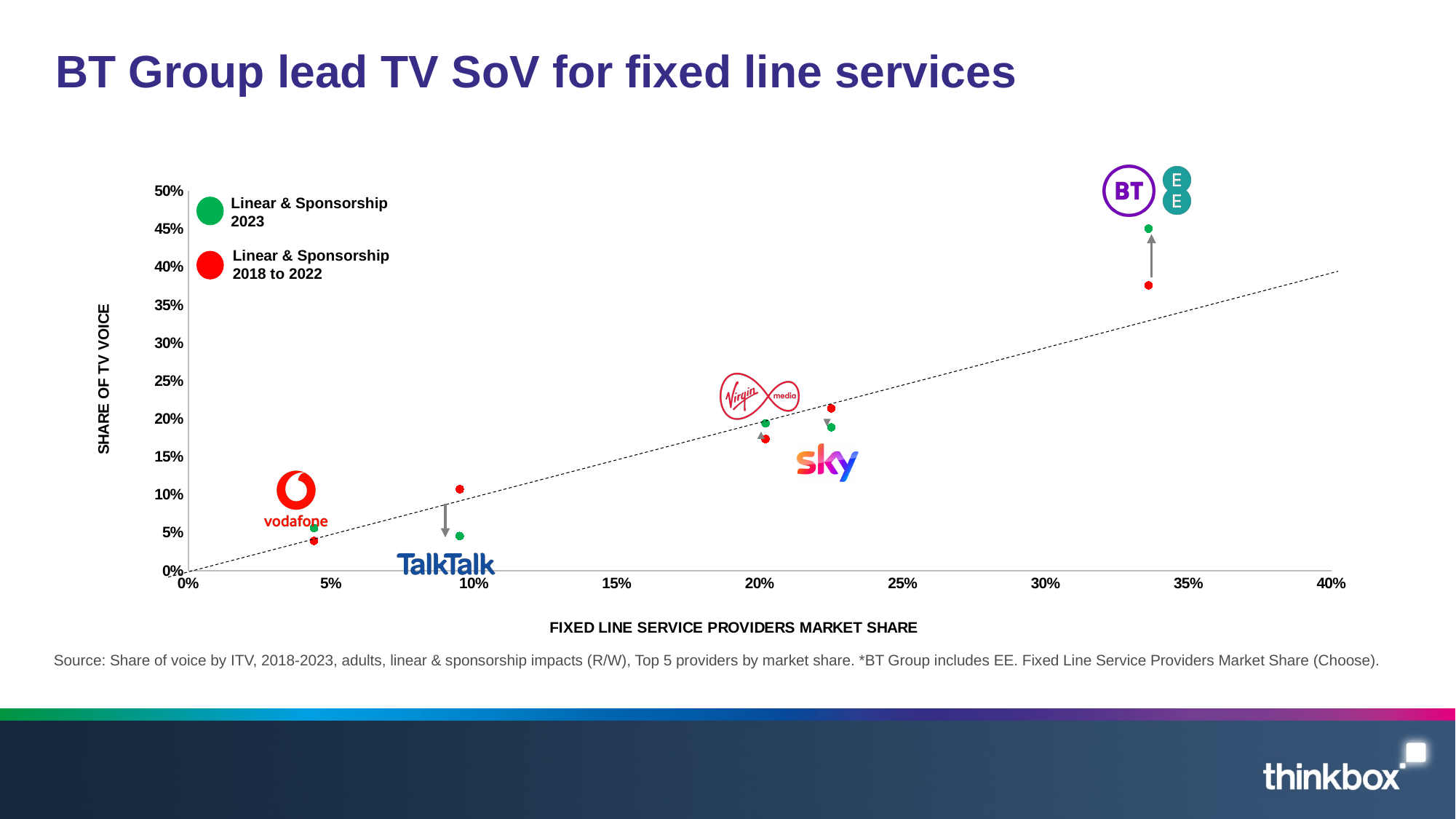
For TalkTalk, which is larger: the share of TV voice for 2023 or for 2018 to 2022? 2018 to 2022 Which provider has the highest share of TV voice for Linear & Sponsorship 2023? BT Group Is the 2023 share of TV voice for TalkTalk greater or less than 10%? less Is the 2023 share of TV voice for BT Group greater or less than 40%? greater How many fixed line service providers are plotted on the chart? 5 What kind of chart is shown on the slide? Scatter chart Which provider has the lowest share of TV voice for Linear & Sponsorship 2018 to 2022? Vodafone How many series does the legend list? 2 What is the label on the vertical axis of the chart? SHARE OF TV VOICE Is the fixed line market share for BT Group greater or less than 30%? greater What colour are the markers for Linear & Sponsorship 2018 to 2022? Red For BT Group, which is larger: the share of TV voice for 2023 or for 2018 to 2022? 2023